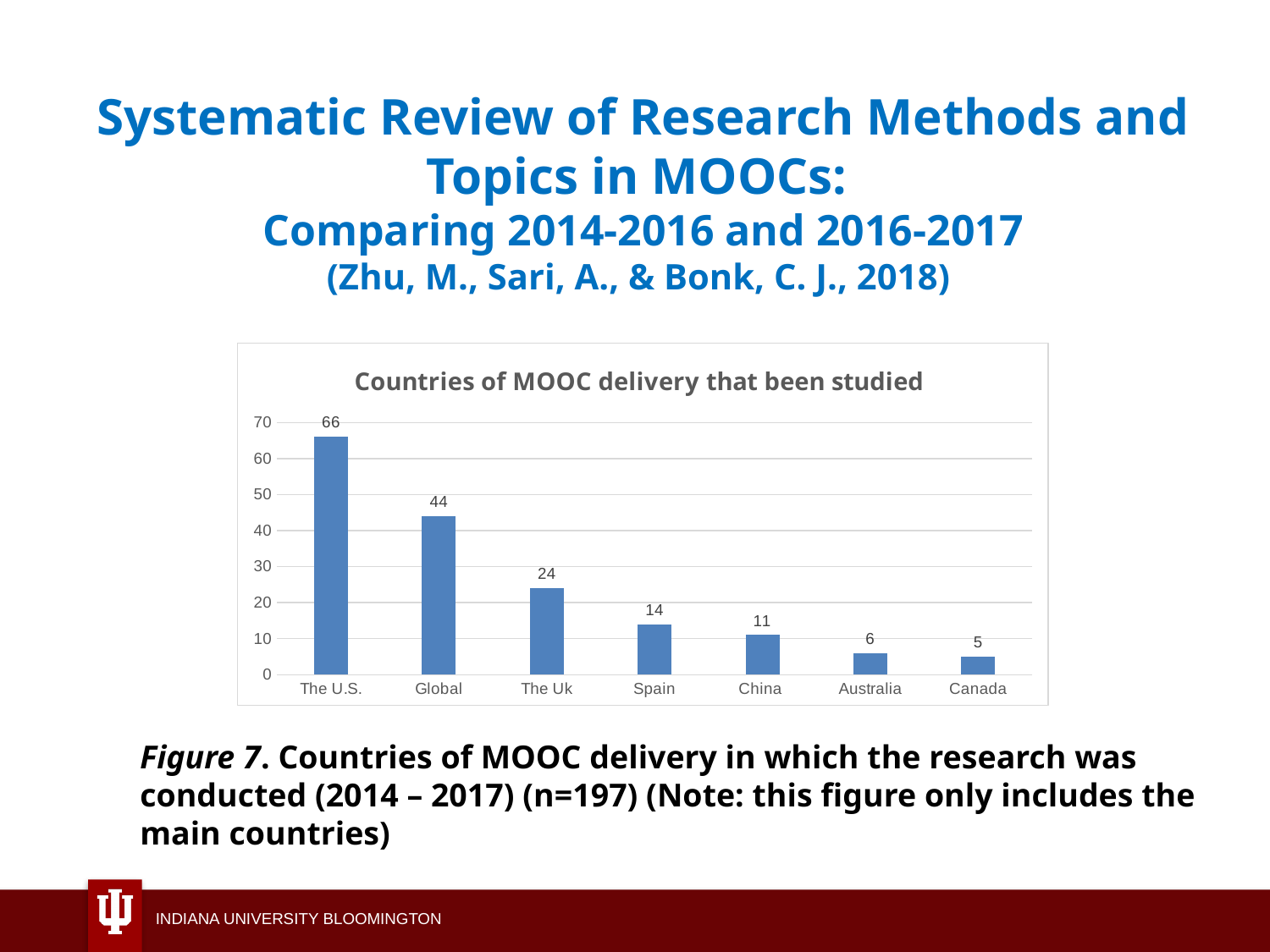
Which is larger, the value for China or the value for Australia? China What is the value for Canada? 5 How many categories are shown on the x axis? 7 What is the value for The U.S.? 66 Is the value for Global greater or less than 40? greater What kind of chart is shown? Bar chart What is the difference between the values for The Uk and China? 13 Which category has the lowest value? Canada Which country has the highest value? The U.S. What is the title of the chart? Countries of MOOC delivery that been studied What is the difference between the values for The U.S. and Global? 22 What is the value for Spain? 14